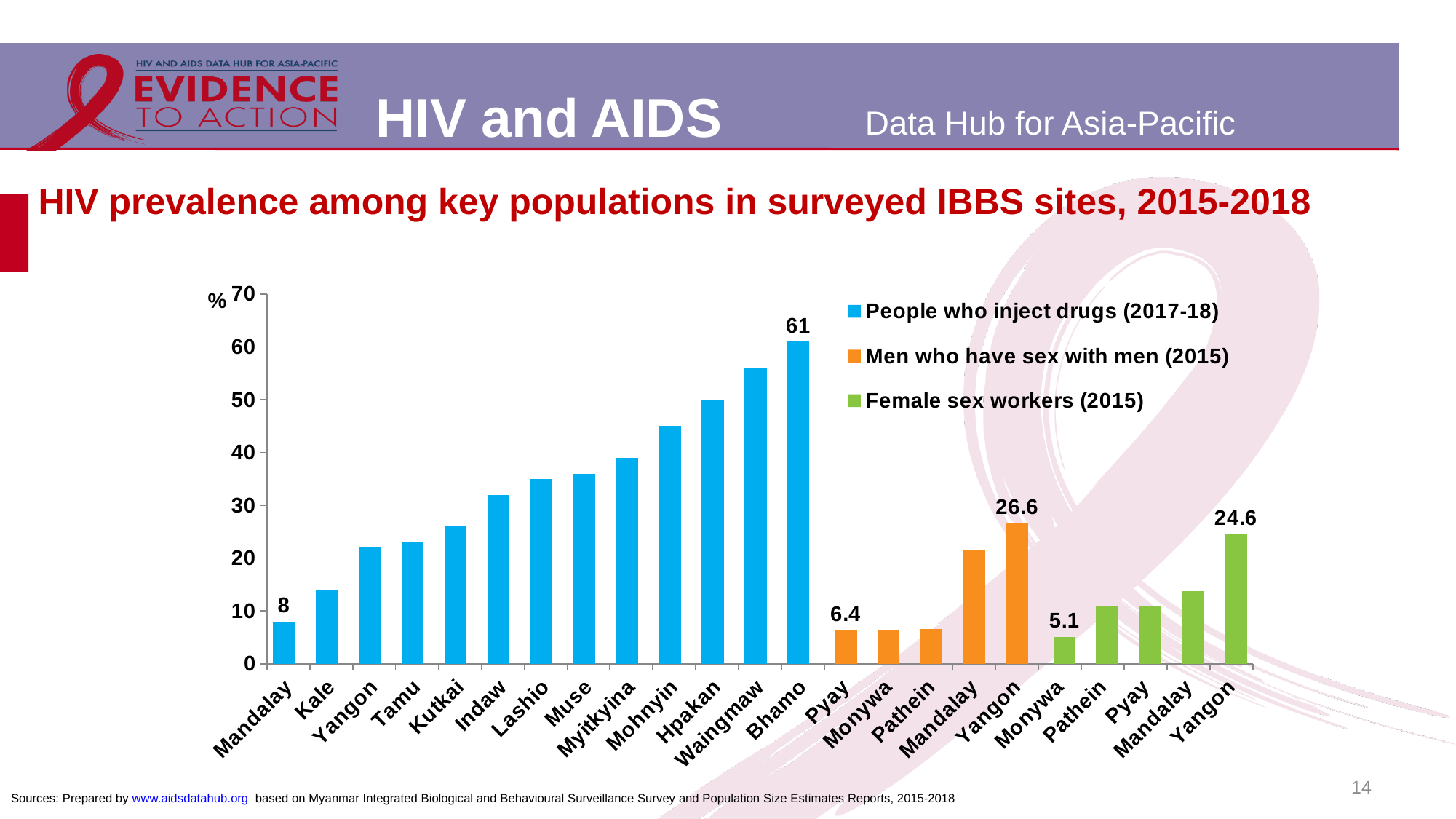
Which site has the lowest HIV prevalence among female sex workers? Monywa What is the HIV prevalence among people who inject drugs in Mandalay? 8 What is the HIV prevalence among men who have sex with men in Yangon? 26.6 What is the HIV prevalence among people who inject drugs in Bhamo? 61 In Yangon, which is higher: HIV prevalence among men who have sex with men or among female sex workers? Men who have sex with men Do the values for people who inject drugs rise or fall from Mandalay to Bhamo along the x axis? rise What is the HIV prevalence among female sex workers in Yangon? 24.6 How many series does the legend list? 3 Is the HIV prevalence among people who inject drugs in Kale greater or less than 20? less Which site has the highest HIV prevalence among people who inject drugs? Bhamo What is the difference between the HIV prevalence among people who inject drugs in Bhamo and in Mandalay? 53 What is the HIV prevalence among female sex workers in Monywa? 5.1